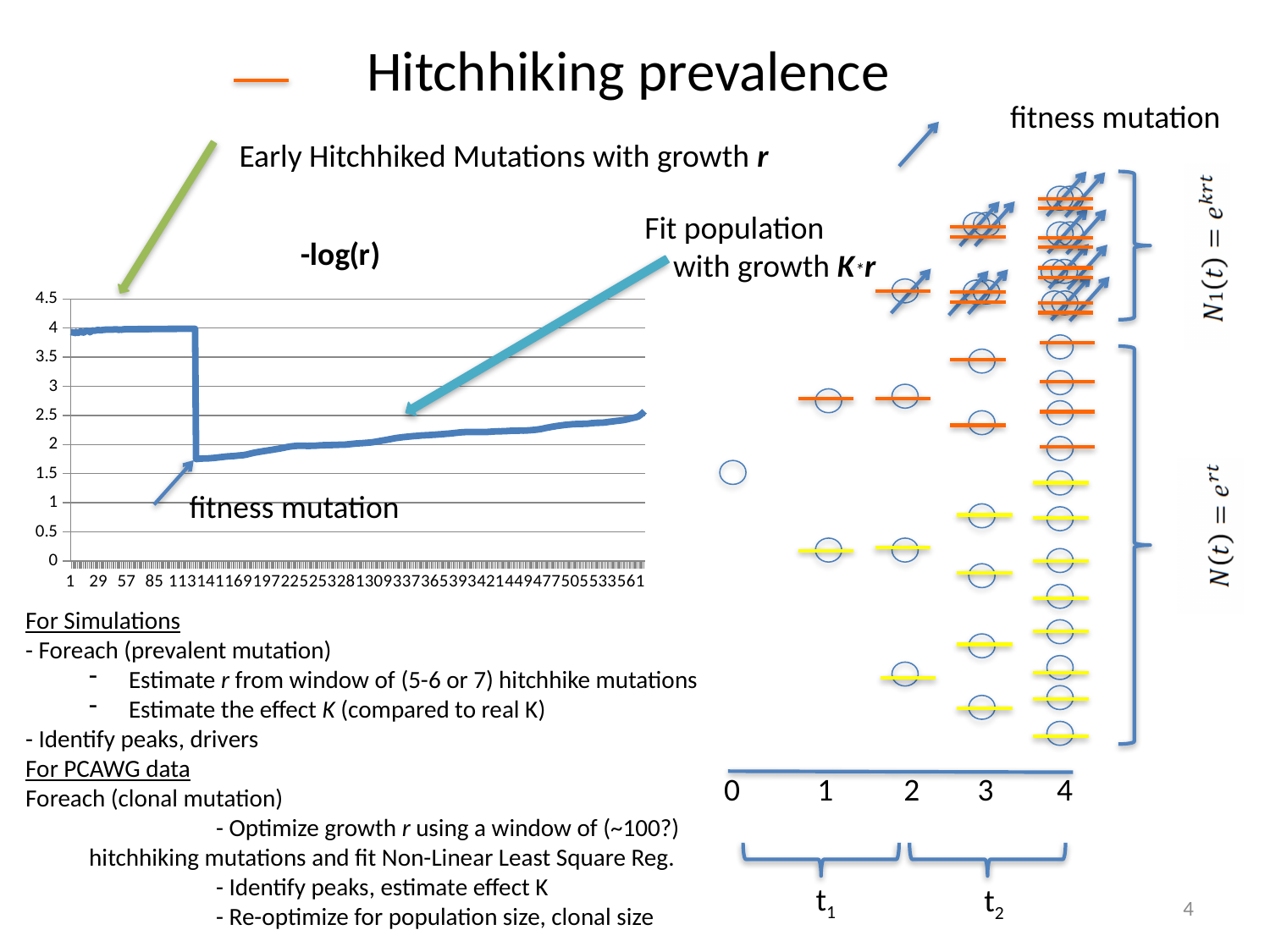
What is the highest tick value shown on the y axis of the "-log(r)" chart? 4.5 In the "-log(r)" chart, do the values rise or fall along the x axis after the sharp drop near x = 113? rise In the "-log(r)" chart, is the value at x = 1 greater or less than 4.5? less In the "-log(r)" chart, is the value at x = 141 greater or less than 2? less How many data series are plotted in the "-log(r)" chart? 1 In the "-log(r)" chart, is the value at x = 1 greater or less than 3.5? greater In the "-log(r)" chart, which is larger: the value at x = 141 or the value at x = 561? x = 561 What is the title of the chart on the left of the slide? -log(r) What kind of chart is the "-log(r)" chart on the slide? line chart In the "-log(r)" chart, which is larger: the value at x = 1 or the value at x = 561? x = 1